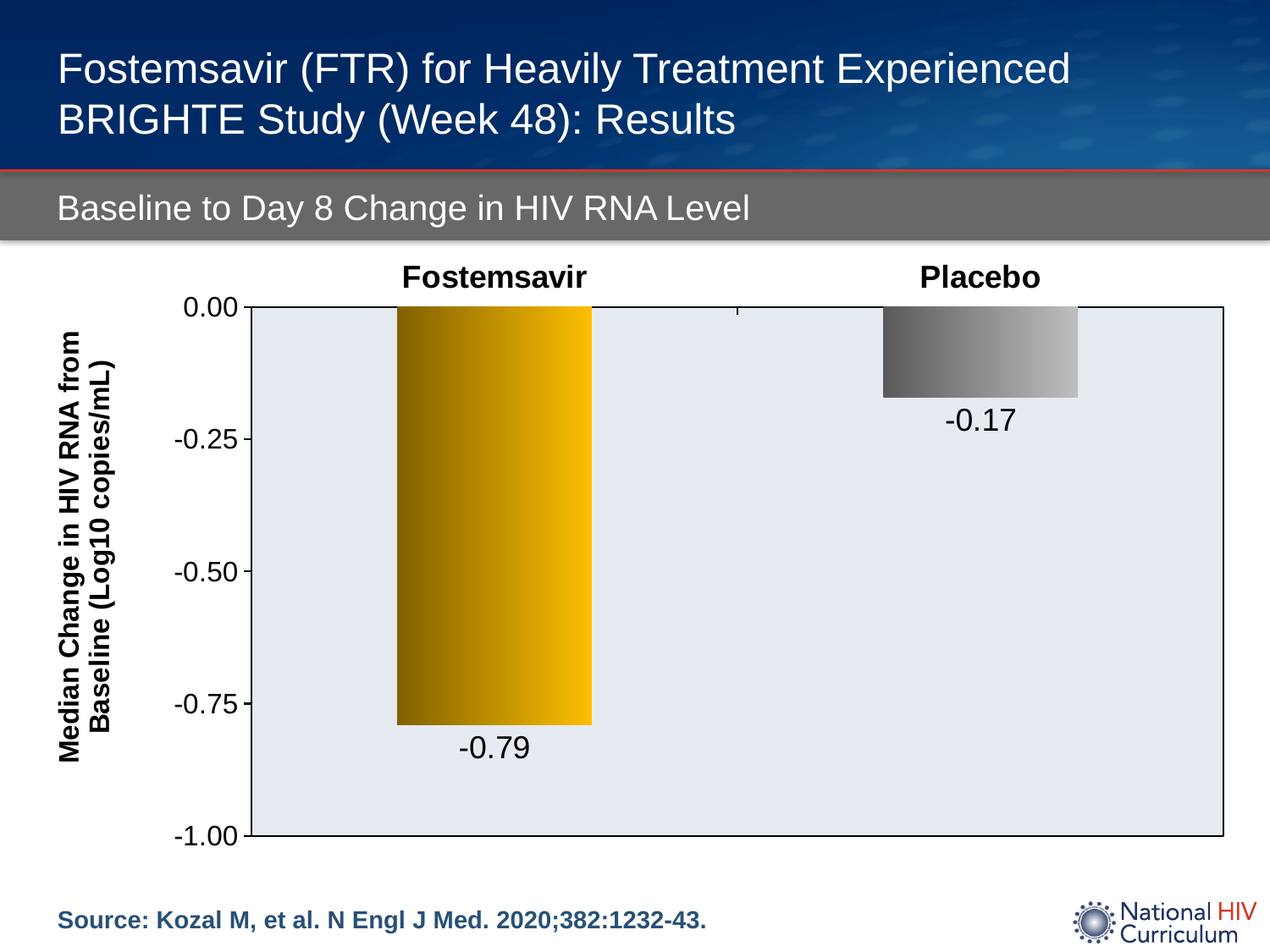
What is the label of the vertical axis? Median Change in HIV RNA from Baseline (Log10 copies/mL) Is the value for Placebo greater or less than -0.25? greater What kind of chart is shown on the slide? Bar chart Is the decrease in HIV RNA larger for Fostemsavir or for Placebo? Fostemsavir Is the value for Fostemsavir greater or less than -0.50? less What is the difference between the Fostemsavir and Placebo median changes in HIV RNA? 0.62 Which group shows the larger decrease in HIV RNA from baseline? Fostemsavir What is the median change in HIV RNA from baseline for Placebo? -0.17 What is the title shown above the chart? Baseline to Day 8 Change in HIV RNA Level What is the median change in HIV RNA from baseline for Fostemsavir? -0.79 Which group shows the smaller decrease in HIV RNA from baseline? Placebo How many groups are plotted in the chart? 2